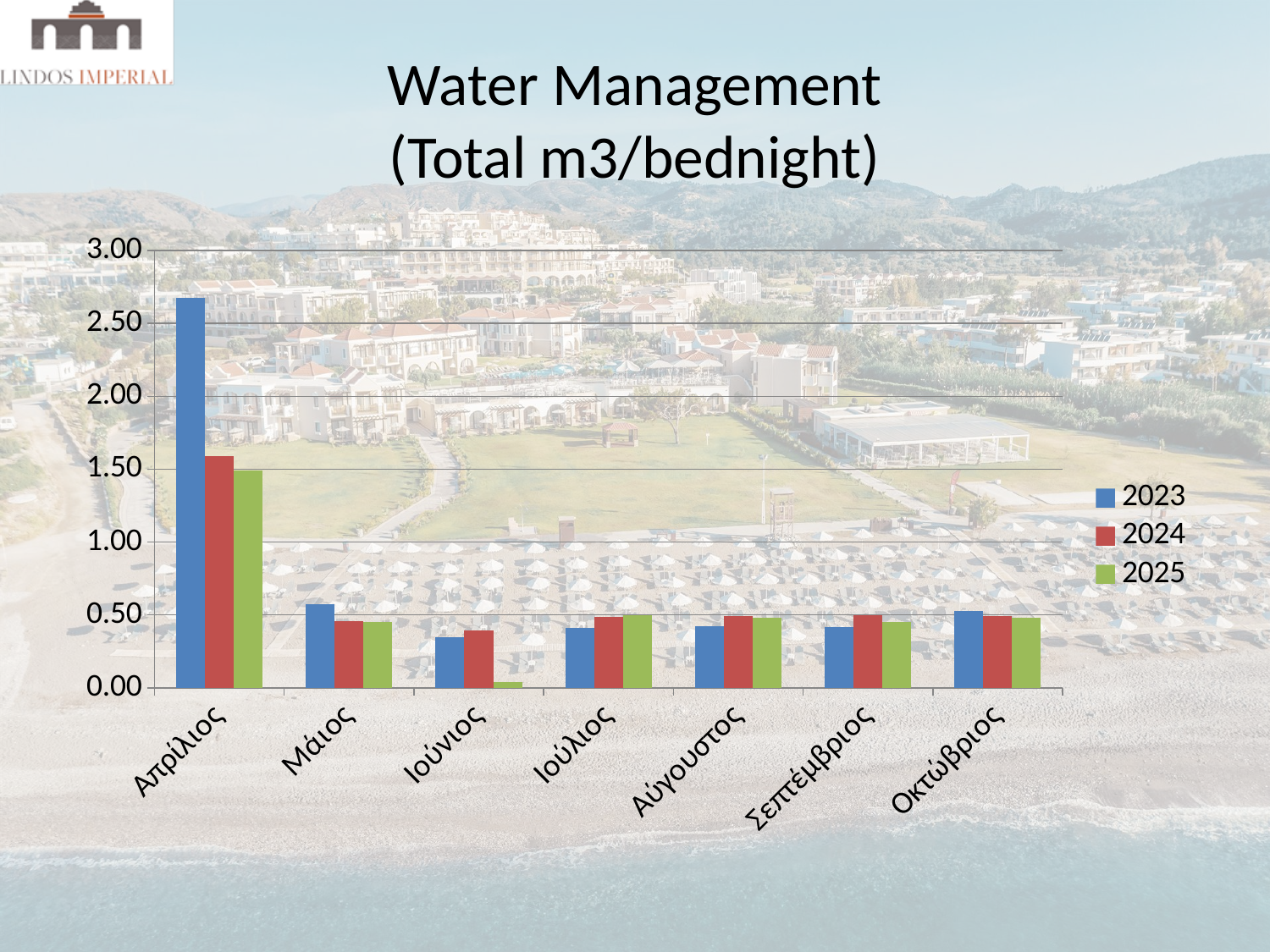
For Απρίλιος, which series has the larger value, 2023 or 2024? 2023 How many series does the legend list? 3 Which month has the highest value for the 2023 series? Απρίλιος How many months (categories) are shown on the x axis? 7 Is the 2025 value for Ιούνιος greater or less than 0.50? less Which series is shown in green in the legend? 2025 For Ιούνιος, which series has the larger value, 2024 or 2025? 2024 What is the title of the chart? Water Management (Total m3/bednight) Is the 2023 value for Ιούνιος greater or less than 0.50? less What kind of chart is shown on the slide? bar chart Is the 2023 value for Απρίλιος greater or less than 2.50? greater Which month has the lowest value for the 2025 series? Ιούνιος